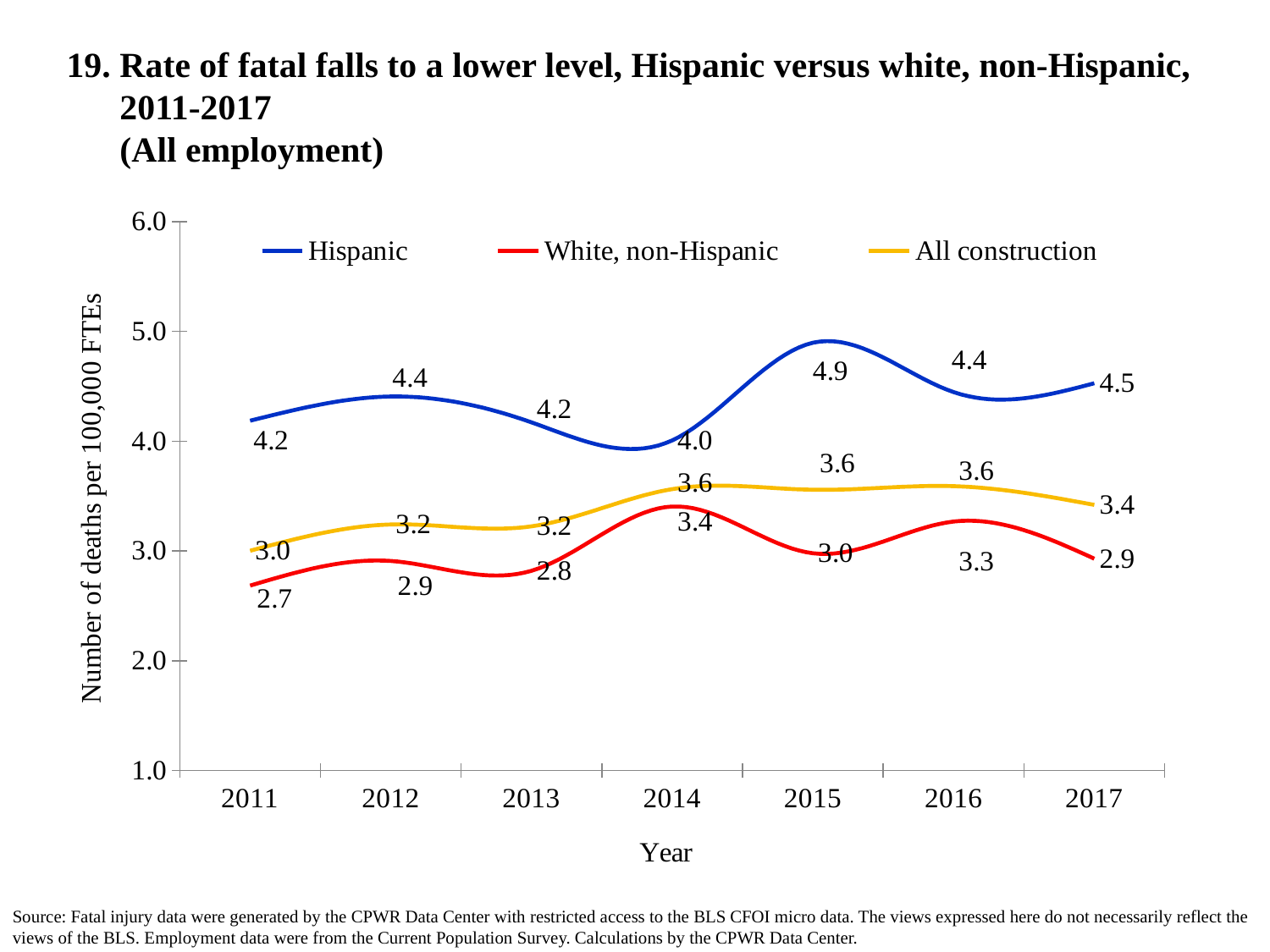
In which year was the Hispanic rate of fatal falls highest? 2015 Which was higher in 2014, the Hispanic rate or the All construction rate? Hispanic What was the All construction rate of fatal falls in 2017? 3.4 What kind of chart is shown on the slide? line chart In which year was the White, non-Hispanic rate of fatal falls lowest? 2011 Which colour is used for the All construction line? yellow Is the Hispanic rate in 2015 greater or less than 5.0? less How many years are shown on the x axis? 7 What is the difference between the Hispanic and White, non-Hispanic rates in 2015? 1.9 What was the rate of fatal falls for White, non-Hispanic workers in 2011? 2.7 What was the rate of fatal falls for Hispanic workers in 2015? 4.9 How many series does the legend list? 3